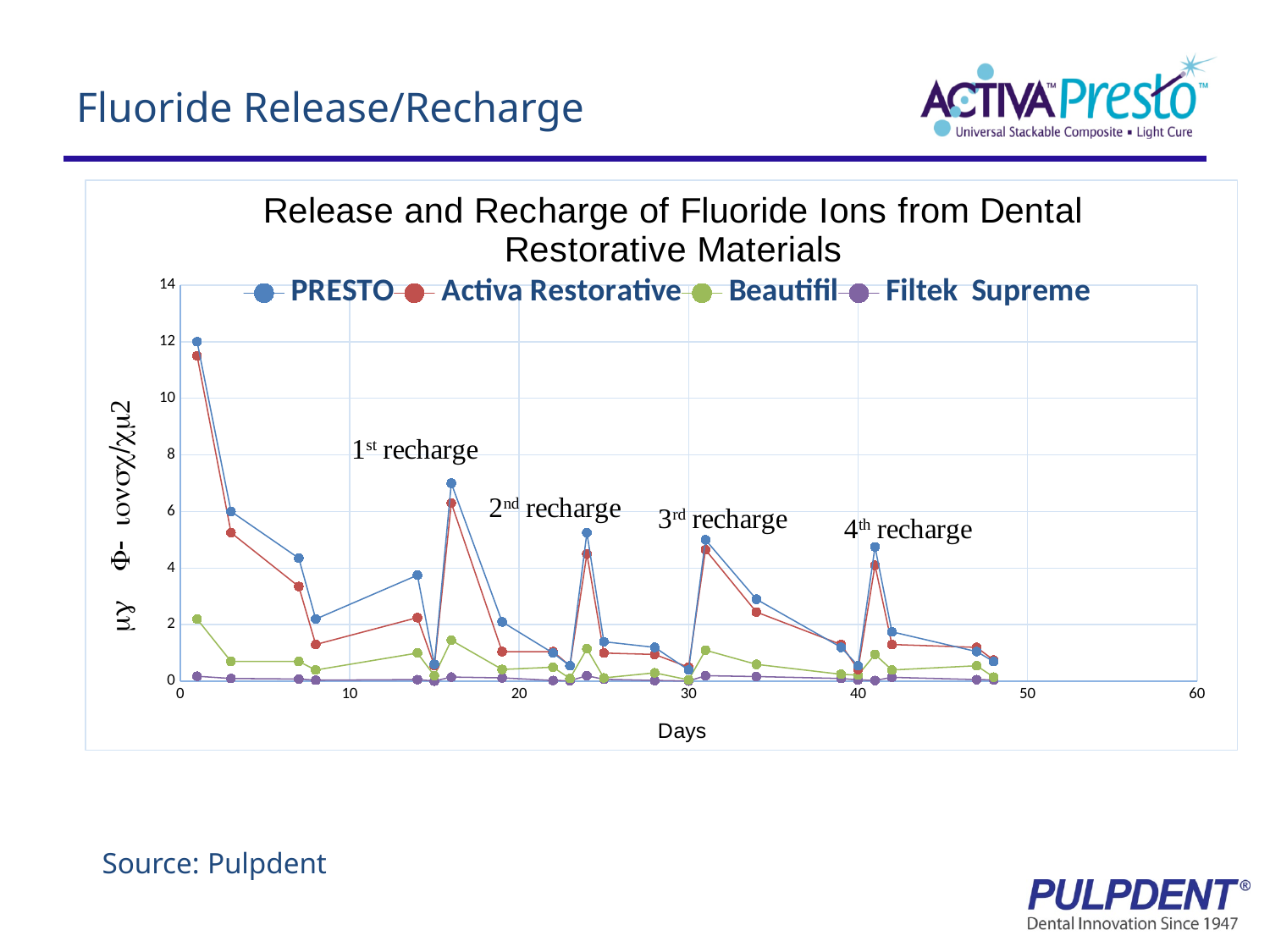
Which series has the lowest value at day 1? Filtek Supreme Is the value for Beautifil at day 1 greater or less than 4? less At day 1, which is larger: the value for Beautifil or the value for Filtek Supreme? Beautifil What is the title of the chart? Release and Recharge of Fluoride Ions from Dental Restorative Materials What is the label of the x axis? Days What kind of chart is shown on the slide? line chart Is the value for Filtek Supreme at day 1 greater or less than 2? less Is the value for PRESTO at day 1 greater or less than 10? greater Which series has the highest value at day 1? PRESTO How many series does the legend list? 4 Does the value for PRESTO rise or fall from day 1 to day 8? fall